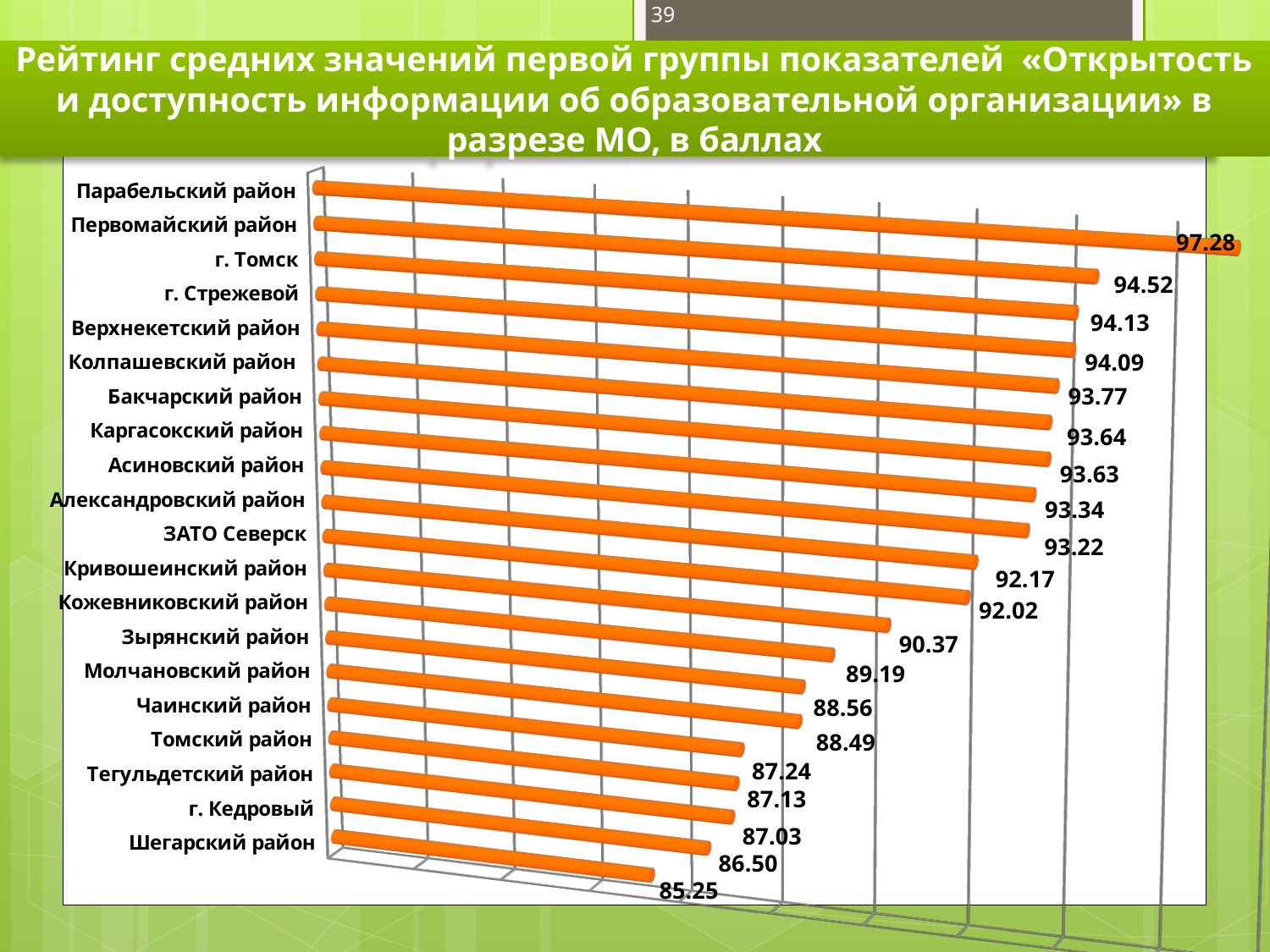
How many categories are shown in the chart? 20 Which category has the highest value? Парабельский район What kind of chart is shown on the slide? Bar chart What is the value for г. Кедровый? 86.50 Which is larger, the value for Кожевниковский район or the value for Чаинский район? Кожевниковский район Which category has the lowest value? Шегарский район What colour are the bars in the chart? Orange What is the value for Парабельский район? 97.28 What is the value for Зырянский район? 88.56 What is the difference between the values for Первомайский район and Кривошеинский район? 4.15 What is the value for ЗАТО Северск? 92.02 What is the difference between the values for Парабельский район and Шегарский район? 12.03